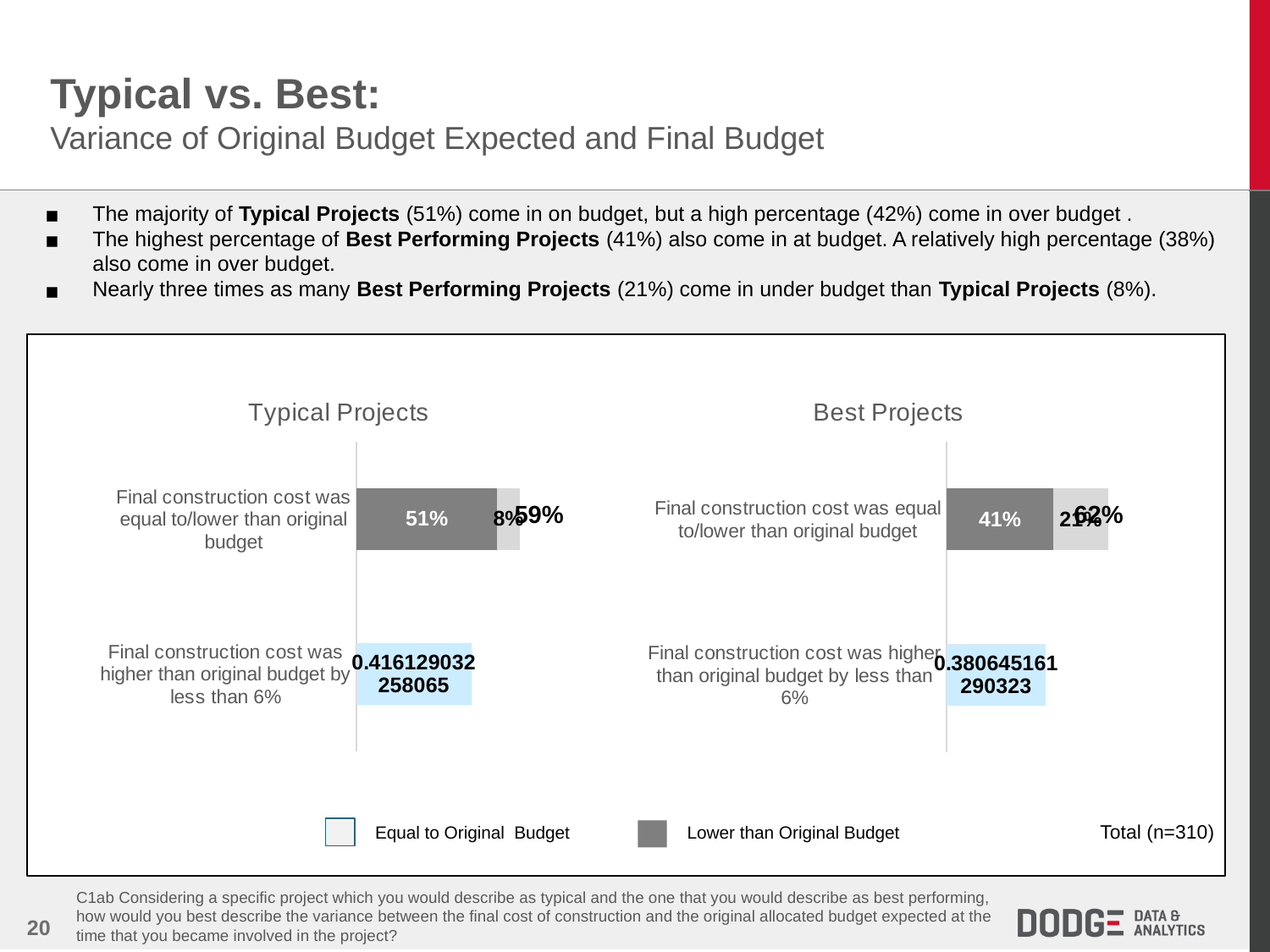
In the Typical Projects chart, what is the total shown at the end of the stacked bar for 'Final construction cost was equal to/lower than original budget'? 59% What is the difference between the dark grey segment values for 'equal to/lower than original budget' in the Typical Projects chart (51%) and the Best Projects chart (41%)? 10% In the Typical Projects chart, what is the value of the dark grey segment of the 'equal to/lower than original budget' bar? 51% Which chart has the larger stacked-bar total for 'equal to/lower than original budget', Typical Projects or Best Projects? Best Projects In the Best Projects chart, what is the total shown at the end of the stacked bar for 'Final construction cost was equal to/lower than original budget'? 62% In the Best Projects chart, what is the value of the light grey segment of the 'equal to/lower than original budget' bar? 21% How many entries does the legend below the charts list? 2 In the Best Projects chart, what is the value of the dark grey segment of the 'equal to/lower than original budget' bar? 41% In the Typical Projects chart, what value is labelled on the bar for 'Final construction cost was higher than original budget by less than 6%'? 0.416129032258065 In the Best Projects chart, what value is labelled on the bar for 'Final construction cost was higher than original budget by less than 6%'? 0.380645161290323 In the Typical Projects chart, what is the value of the light grey segment of the 'equal to/lower than original budget' bar? 8% What type of chart is used for Typical Projects and Best Projects? Bar chart